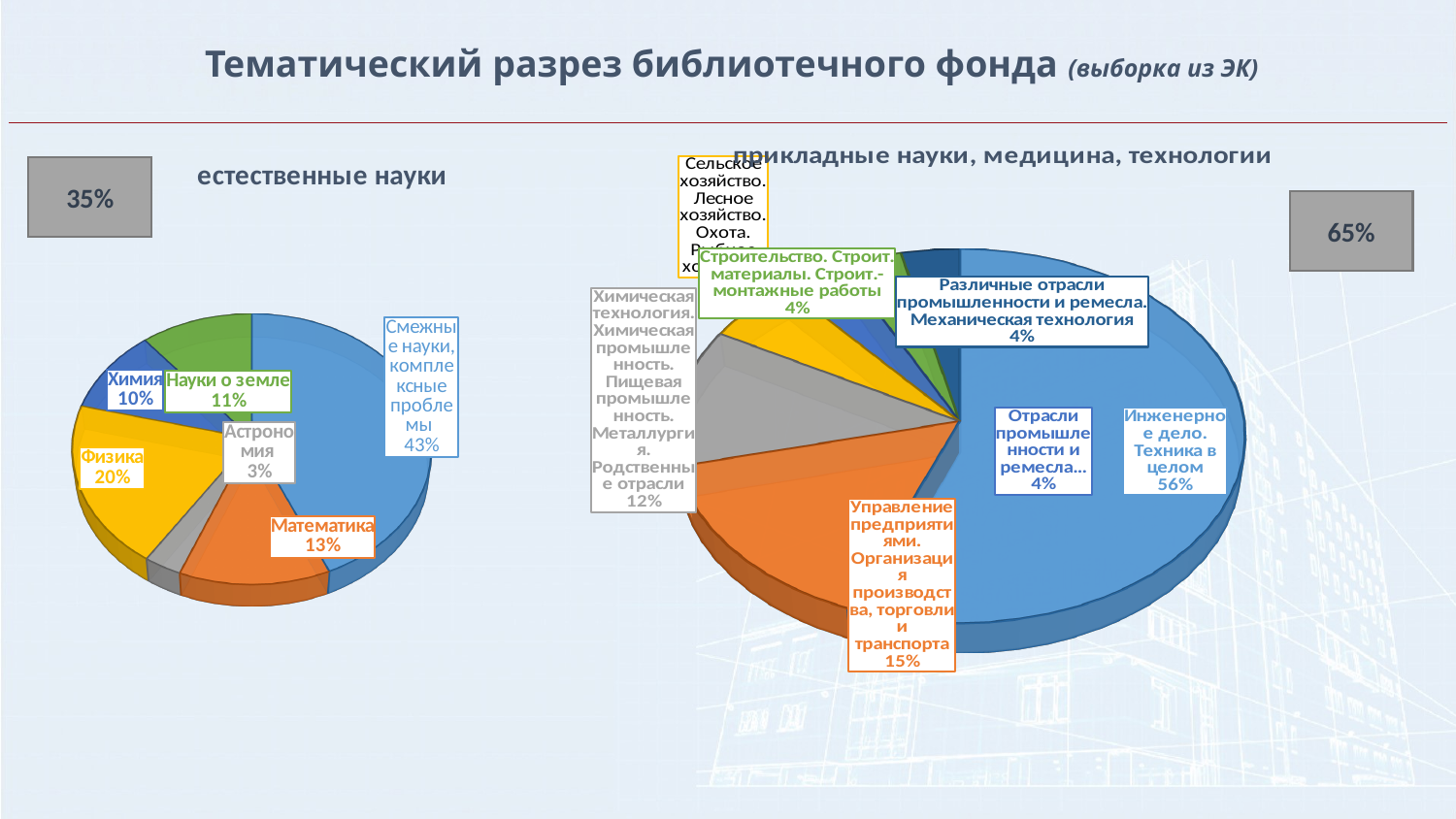
On the 'естественные науки' pie chart, what share is labelled for Математика? 13% On the 'естественные науки' pie chart, what is the difference between the shares of Физика and Химия? 10% On the 'естественные науки' pie chart, which is larger: Науки о земле or Химия? Науки о земле On the 'естественные науки' pie chart, which category has the smallest share? Астрономия On the 'естественные науки' pie chart, what share is labelled for Физика? 20% On the 'прикладные науки, медицина, технологии' pie chart, what is the difference between the shares of 'Инженерное дело. Техника в целом' and 'Управление предприятиями...'? 41% What type of chart is used on the left side of the slide for 'естественные науки'? Pie chart How many slices does the 'естественные науки' pie chart have? 6 On the 'естественные науки' pie chart, which category has the largest share? Смежные науки, комплексные проблемы On the 'прикладные науки, медицина, технологии' pie chart, what share is labelled for 'Управление предприятиями. Организация производства, торговли и транспорта'? 15% On the 'прикладные науки, медицина, технологии' pie chart, what share is labelled for 'Строительство. Строит. материалы. Строит.-монтажные работы'? 4% On the 'прикладные науки, медицина, технологии' pie chart, what share is labelled for 'Инженерное дело. Техника в целом'? 56%